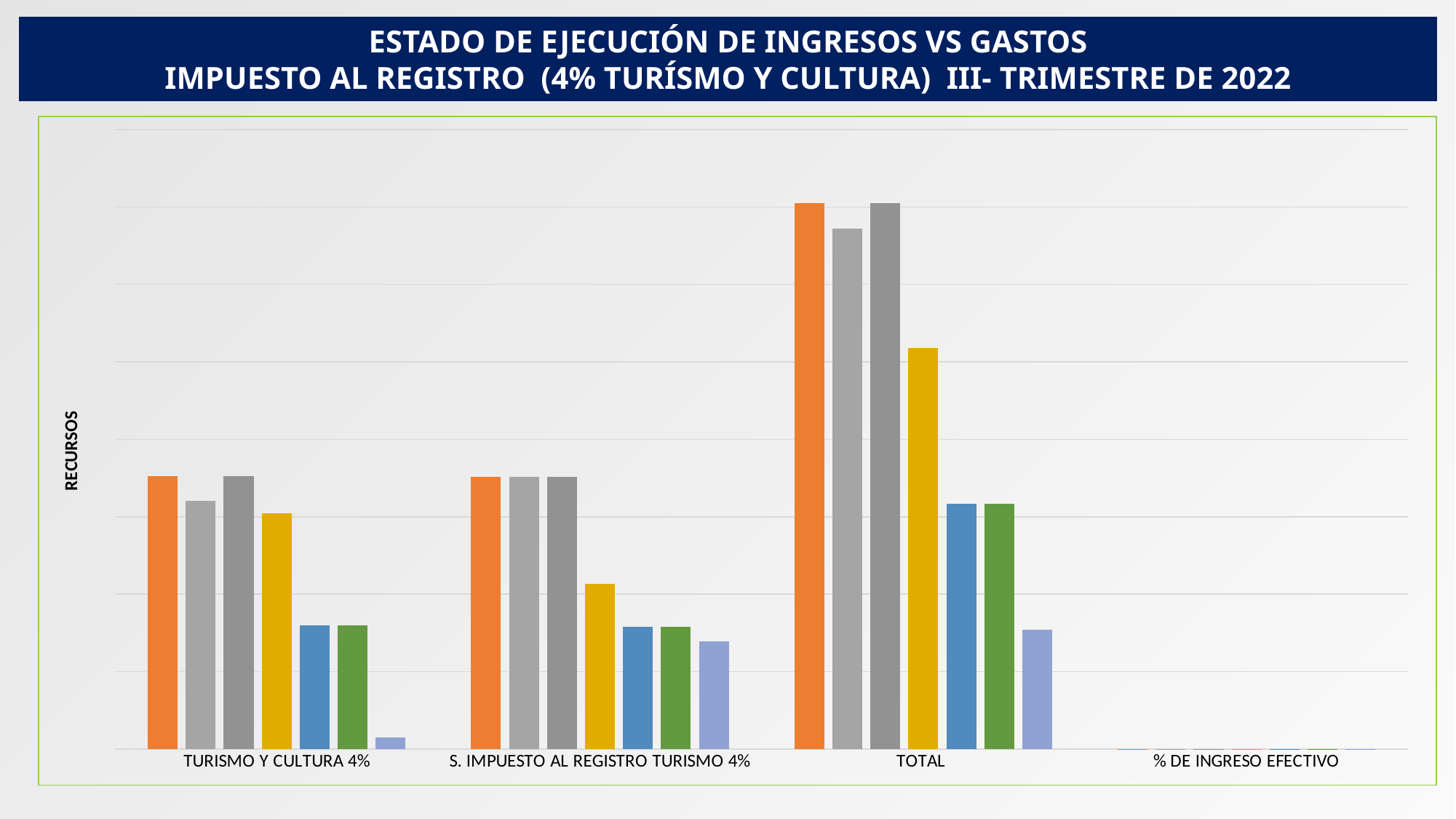
In the TURISMO Y CULTURA 4% category, is the light purple bar or the green bar taller? green How many bars are plotted for the TOTAL category? 7 Which category has the tallest bars in the chart? TOTAL In the TOTAL category, is the orange bar or the yellow bar taller? orange Is the orange bar taller for TOTAL or for TURISMO Y CULTURA 4%? TOTAL What is the label on the vertical axis of the chart? RECURSOS What is the label of the third category on the x axis? TOTAL Which category has the lowest bars in the chart? % DE INGRESO EFECTIVO What kind of chart is shown on the slide? bar chart How many categories are shown along the x axis of the chart? 4